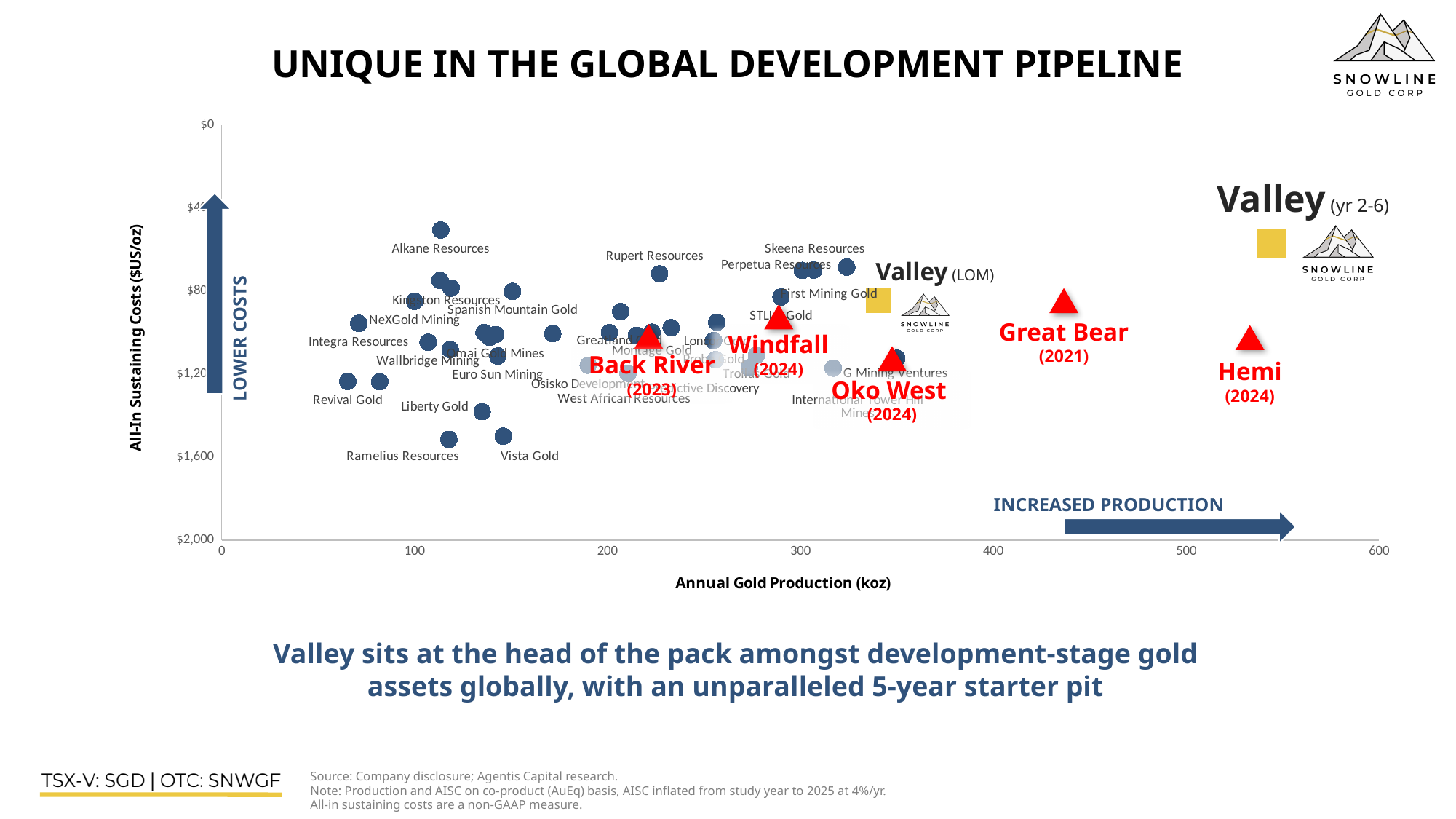
How many projects are marked with red triangles on the chart? 5 Is the all-in sustaining cost for Oko West greater or less than $800? greater Is the annual gold production for Back River greater or less than 300 koz? less Is the all-in sustaining cost for Hemi greater or less than $800? greater What kind of chart is shown on the slide? scatter chart What is the title of the x axis of the chart? Annual Gold Production (koz) Which has the higher annual gold production, Great Bear or Windfall? Great Bear What is the title of the y axis of the chart? All-In Sustaining Costs ($US/oz) Which has the lower all-in sustaining cost, Valley (yr 2-6) or Hemi? Valley (yr 2-6)